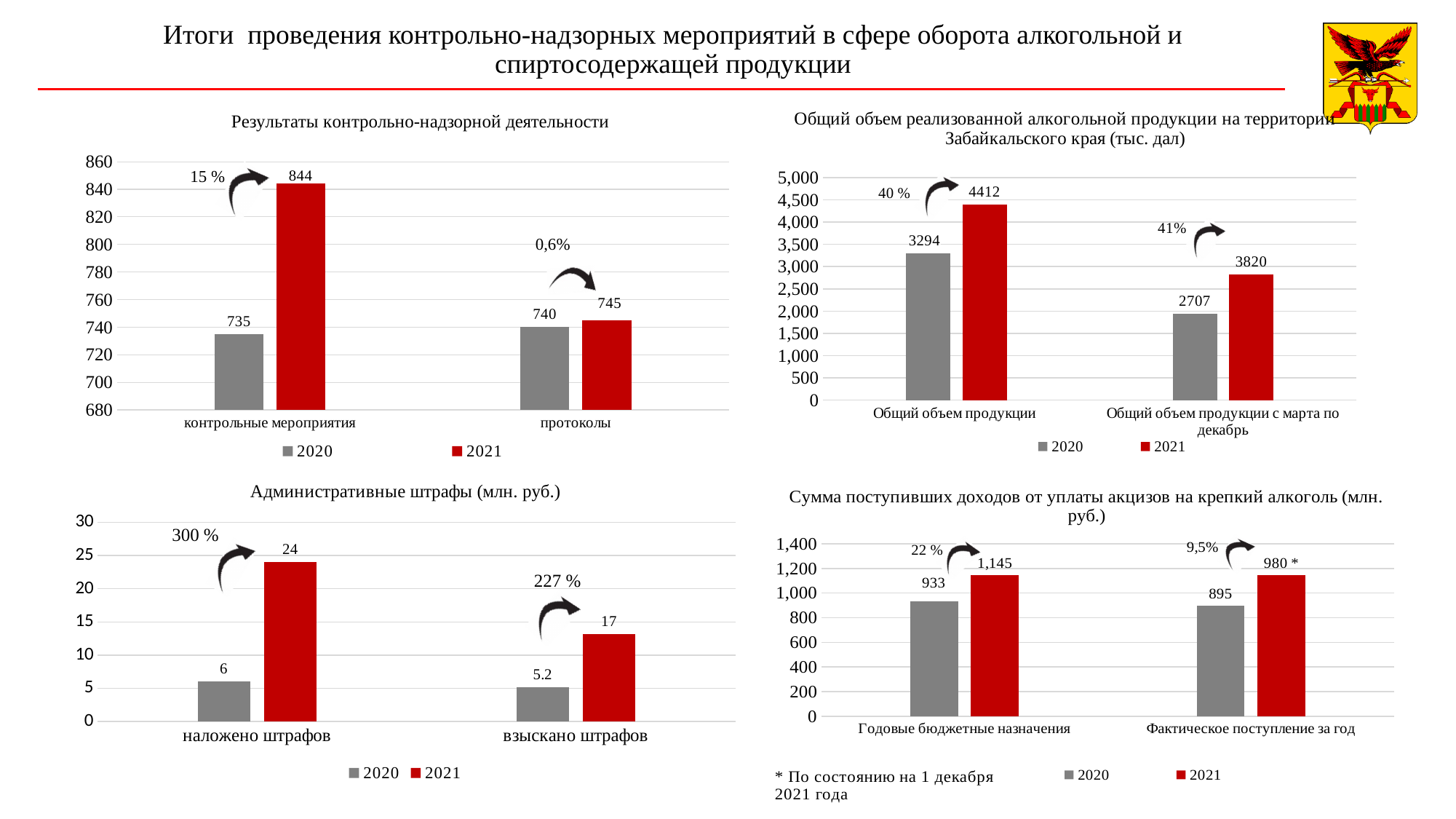
In the chart 'Административные штрафы (млн. руб.)', what is the 2021 value for 'наложено штрафов'? 24 In the chart 'Сумма поступивших доходов от уплаты акцизов на крепкий алкоголь', what is the 2021 value for 'Годовые бюджетные назначения'? 1,145 In the chart 'Административные штрафы (млн. руб.)', which is larger: the 2021 value for 'наложено штрафов' or the 2021 value for 'взыскано штрафов'? наложено штрафов In the chart 'Результаты контрольно-надзорной деятельности', what is the difference between the 2021 and 2020 values for 'контрольные мероприятия'? 109 In the chart 'Общий объем реализованной алкогольной продукции', which bar has the highest value? Общий объем продукции, 2021 In the chart 'Общий объем реализованной алкогольной продукции', what is the 2020 value for 'Общий объем продукции'? 3294 In the chart 'Результаты контрольно-надзорной деятельности', what is the 2020 value for 'протоколы'? 740 In the chart 'Административные штрафы (млн. руб.)', what is the 2020 value for 'взыскано штрафов'? 5.2 In the chart 'Сумма поступивших доходов от уплаты акцизов на крепкий алкоголь', what is the 2020 value for 'Фактическое поступление за год'? 895 In the chart 'Общий объем реализованной алкогольной продукции', what is the 2021 value for 'Общий объем продукции с марта по декабрь'? 3820 In the chart 'Результаты контрольно-надзорной деятельности', what is the 2021 value for 'контрольные мероприятия'? 844 How many series does the legend list in the chart 'Административные штрафы (млн. руб.)'? 2